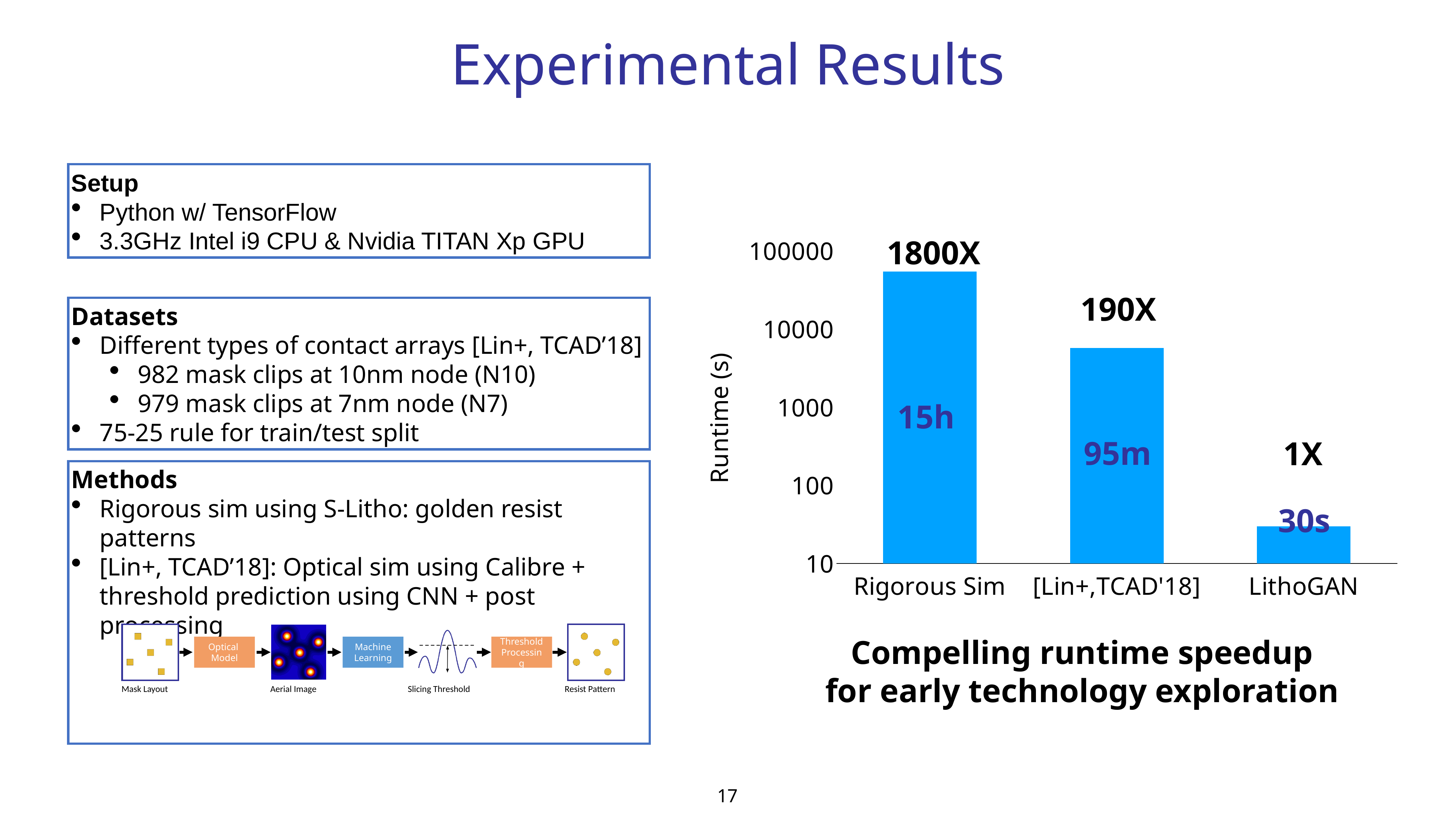
Is the runtime value for Rigorous Sim greater or less than 10000 seconds? greater How many categories are plotted on the x axis of the runtime chart? 3 What speedup factor is printed above the Rigorous Sim bar? 1800X What kind of chart is shown on the slide? bar chart Which category has the highest runtime? Rigorous Sim Which category has the lowest runtime? LithoGAN What runtime is labelled on the [Lin+,TCAD'18] bar? 95m What speedup factor is printed above the [Lin+,TCAD'18] bar? 190X What runtime is labelled on the Rigorous Sim bar? 15h Which has a larger runtime, [Lin+,TCAD'18] or LithoGAN? [Lin+,TCAD'18] What is the label on the y axis of the chart? Runtime (s) What runtime is labelled on the LithoGAN bar? 30s